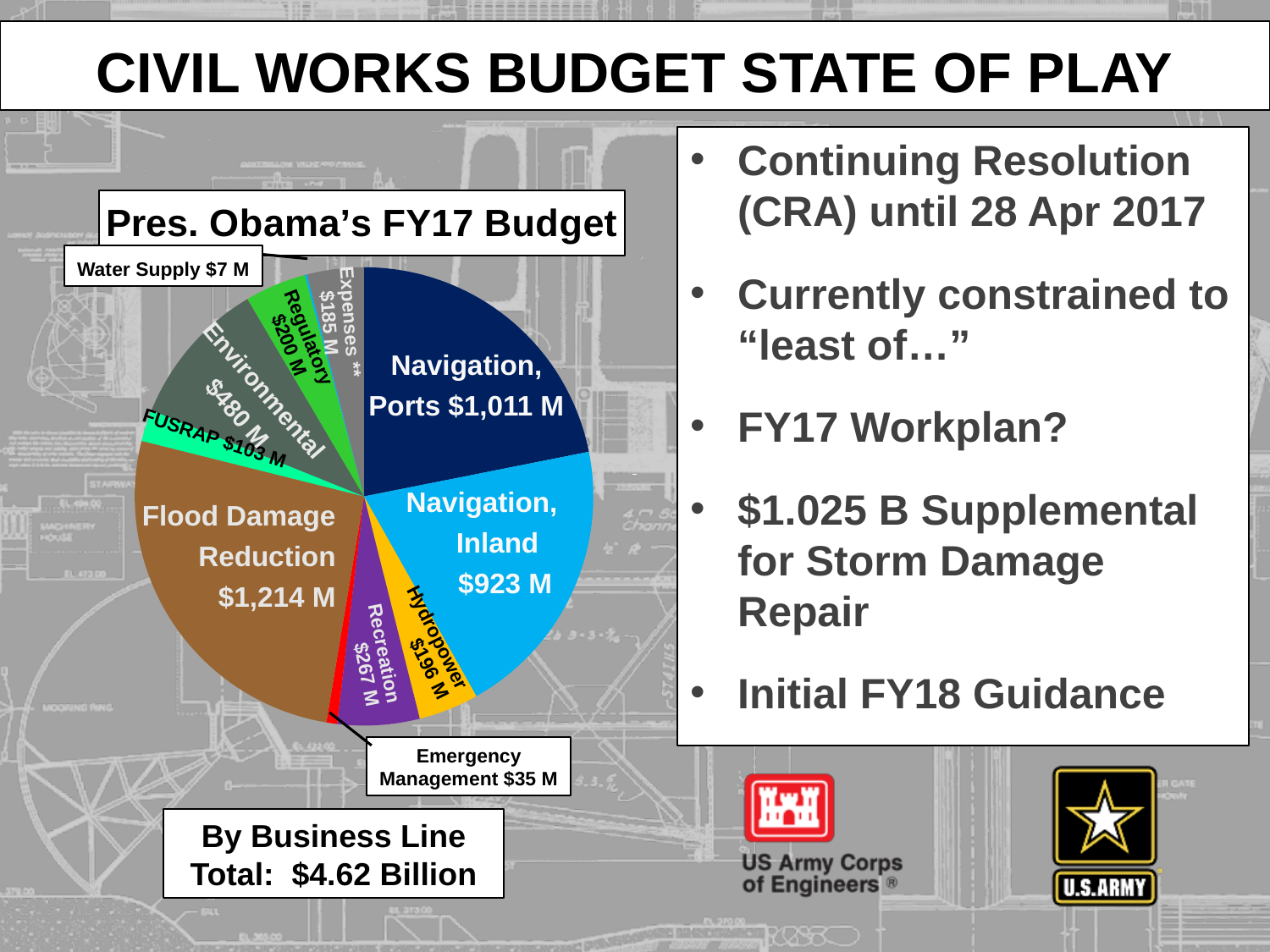
Which is larger in the pie chart, Recreation or Hydropower? Recreation Which business line has the largest slice of the pie chart? Flood Damage Reduction What is the difference between Flood Damage Reduction and Navigation, Ports in the pie chart? $203 M What total is stated for the pie chart? $4.62 Billion What is the value for Hydropower in the pie chart? $196 M What kind of chart is shown on the slide? Pie chart How many slices does the pie chart have? 11 What is the value for Flood Damage Reduction in the pie chart? $1,214 M What is the value for Environmental in the pie chart? $480 M What is the value for Emergency Management in the pie chart? $35 M Which business line has the smallest slice of the pie chart? Water Supply What is the value for Navigation, Ports in the pie chart? $1,011 M